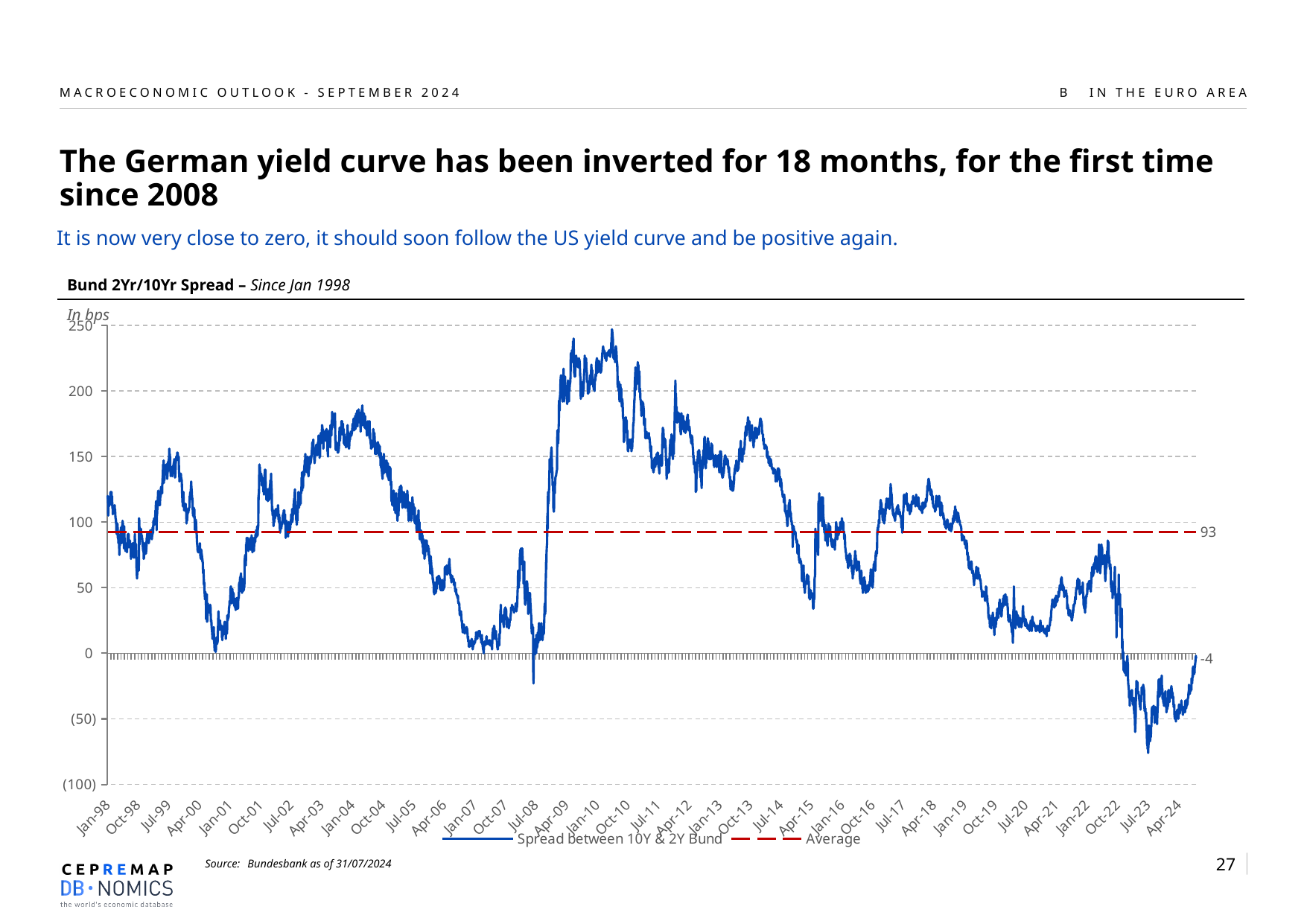
What is the value of the Average line shown on the chart? 93 What is the latest value of the spread between 10Y & 2Y Bund labelled at the end of the line? -4 Is the spread around Jan-10 greater or less than 200? greater What is the difference between the Average (93) and the latest spread value (-4)? 97 What kind of chart is shown on the slide? line chart How many series does the legend list? 2 Is the spread around Jul-23 greater or less than 0? less In what unit are the values on the chart expressed? bps Is the latest spread value (-4) greater or less than the Average (93)? less What is the title of the chart? Bund 2Yr/10Yr Spread – Since Jan 1998 Is the spread around Jan-01 greater or less than 50? less